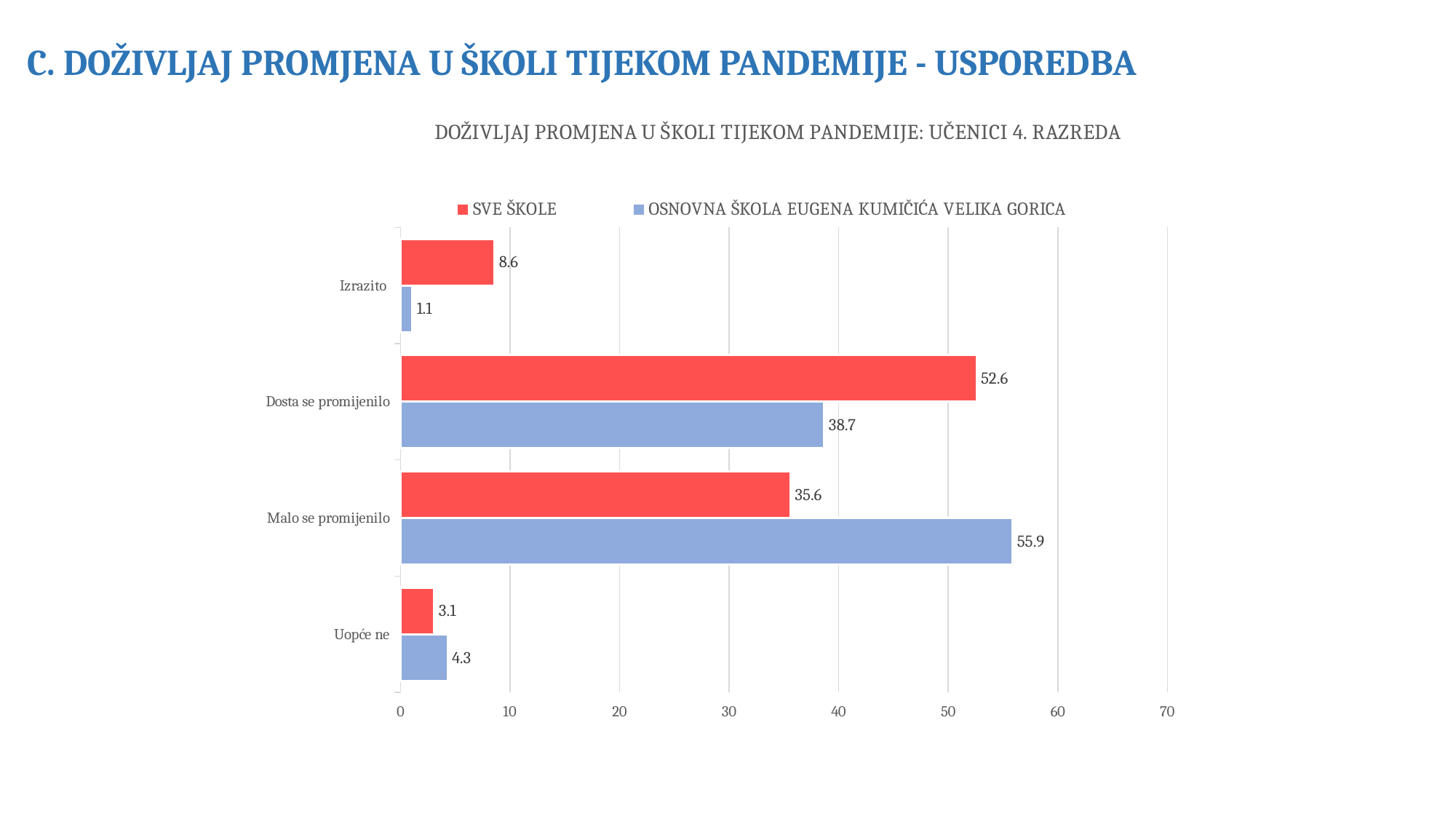
What colour represents the SVE ŠKOLE series? Red How many series does the legend list? 2 What is the value for OSNOVNA ŠKOLA EUGENA KUMIČIĆA VELIKA GORICA in the 'Izrazito' category? 1.1 What is the value for SVE ŠKOLE in the 'Uopće ne' category? 3.1 What kind of chart is shown on the slide? Bar chart What is the value for OSNOVNA ŠKOLA EUGENA KUMIČIĆA VELIKA GORICA in the 'Malo se promijenilo' category? 55.9 In the 'Uopće ne' category, which series has the larger value? OSNOVNA ŠKOLA EUGENA KUMIČIĆA VELIKA GORICA What is the difference between the SVE ŠKOLE and OSNOVNA ŠKOLA EUGENA KUMIČIĆA VELIKA GORICA values in the 'Dosta se promijenilo' category? 13.9 Which category has the highest value for SVE ŠKOLE? Dosta se promijenilo What is the value for SVE ŠKOLE in the 'Dosta se promijenilo' category? 52.6 How many categories are shown on the chart? 4 Which category has the lowest value for OSNOVNA ŠKOLA EUGENA KUMIČIĆA VELIKA GORICA? Izrazito